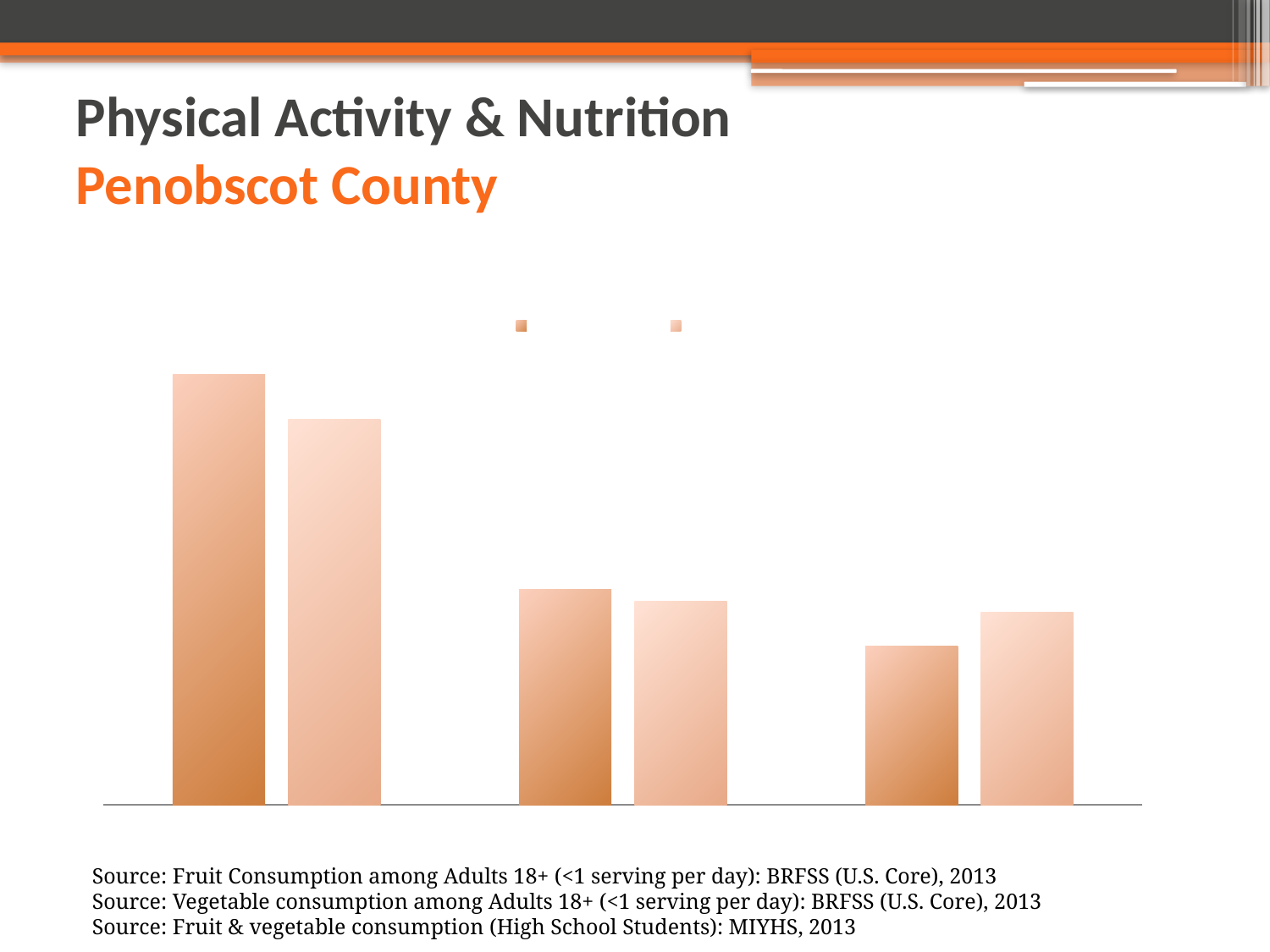
What kind of chart is shown on the slide? bar chart In the rightmost group of bars, is the darker bar or the lighter bar taller? the lighter bar In the leftmost group of bars, is the darker bar or the lighter bar taller? the darker bar How many series does the chart's legend list? 2 How many bars are plotted in total in the chart? 6 Do the darker-series bars rise or fall from left to right across the chart? fall Which group of bars, by position, has the tallest bars in the chart? the leftmost group Which group of bars, by position, contains the shortest bar in the chart? the rightmost group What is the subtitle shown in orange below the slide title? Penobscot County How many groups of bars are plotted in the chart? 3